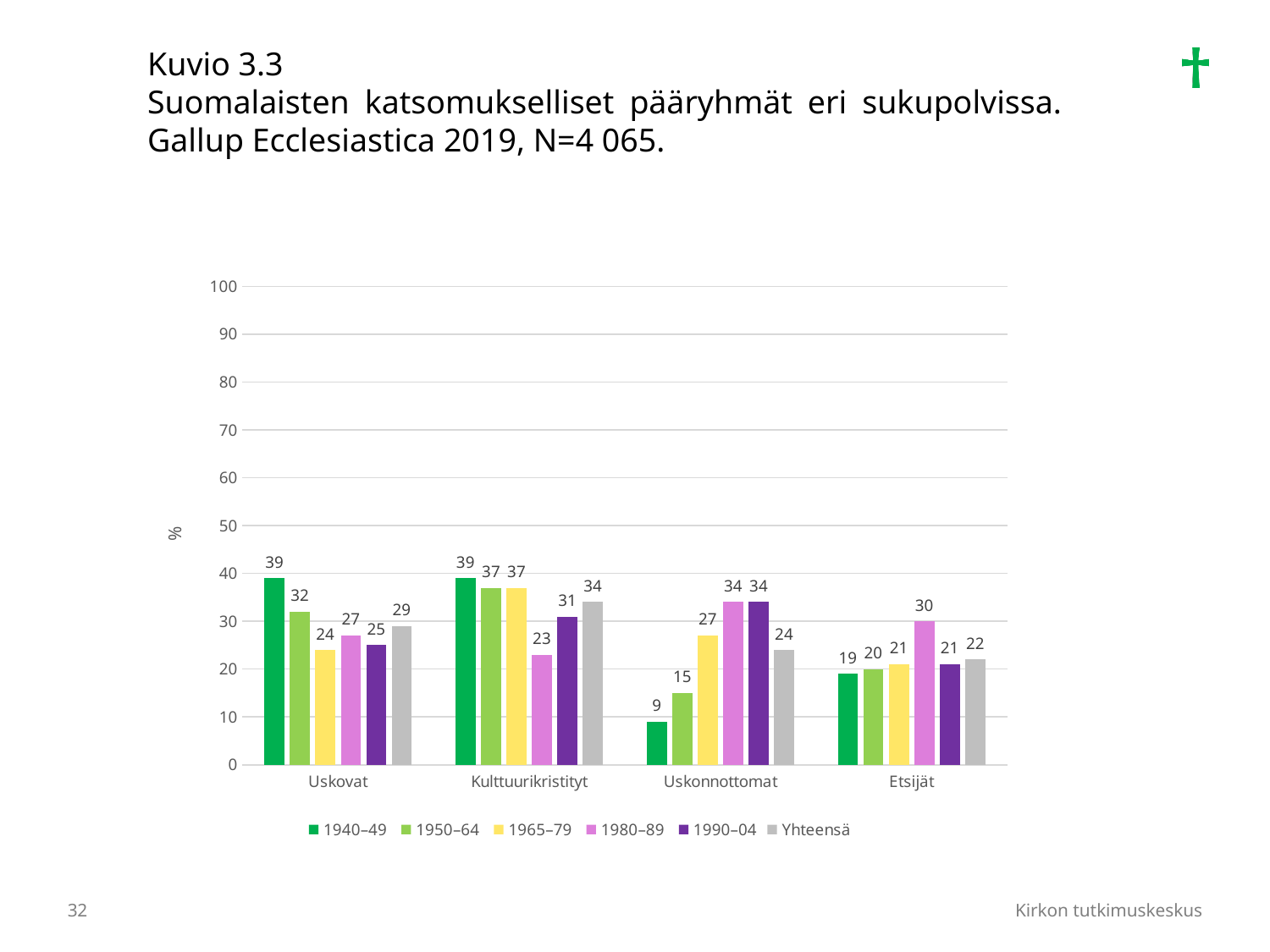
What is the value for the Yhteensä series in the Uskonnottomat category? 24 Which series has the lowest value in the Uskonnottomat category? 1940–49 How many series does the legend list? 6 What is the value for the 1980–89 series in the Etsijät category? 30 Which is larger in the Kulttuurikristityt category: the 1980–89 value or the 1990–04 value? 1990–04 What is the difference between the 1940–49 and 1990–04 values in the Uskonnottomat category? 25 What kind of chart is shown on the slide? bar chart What is the label on the vertical axis? % Is the value for the 1965–79 series in the Uskovat category greater or less than 30? less What is the value for the 1940–49 series in the Uskovat category? 39 How many categories are shown on the x axis? 4 Which series has the highest value in the Etsijät category? 1980–89